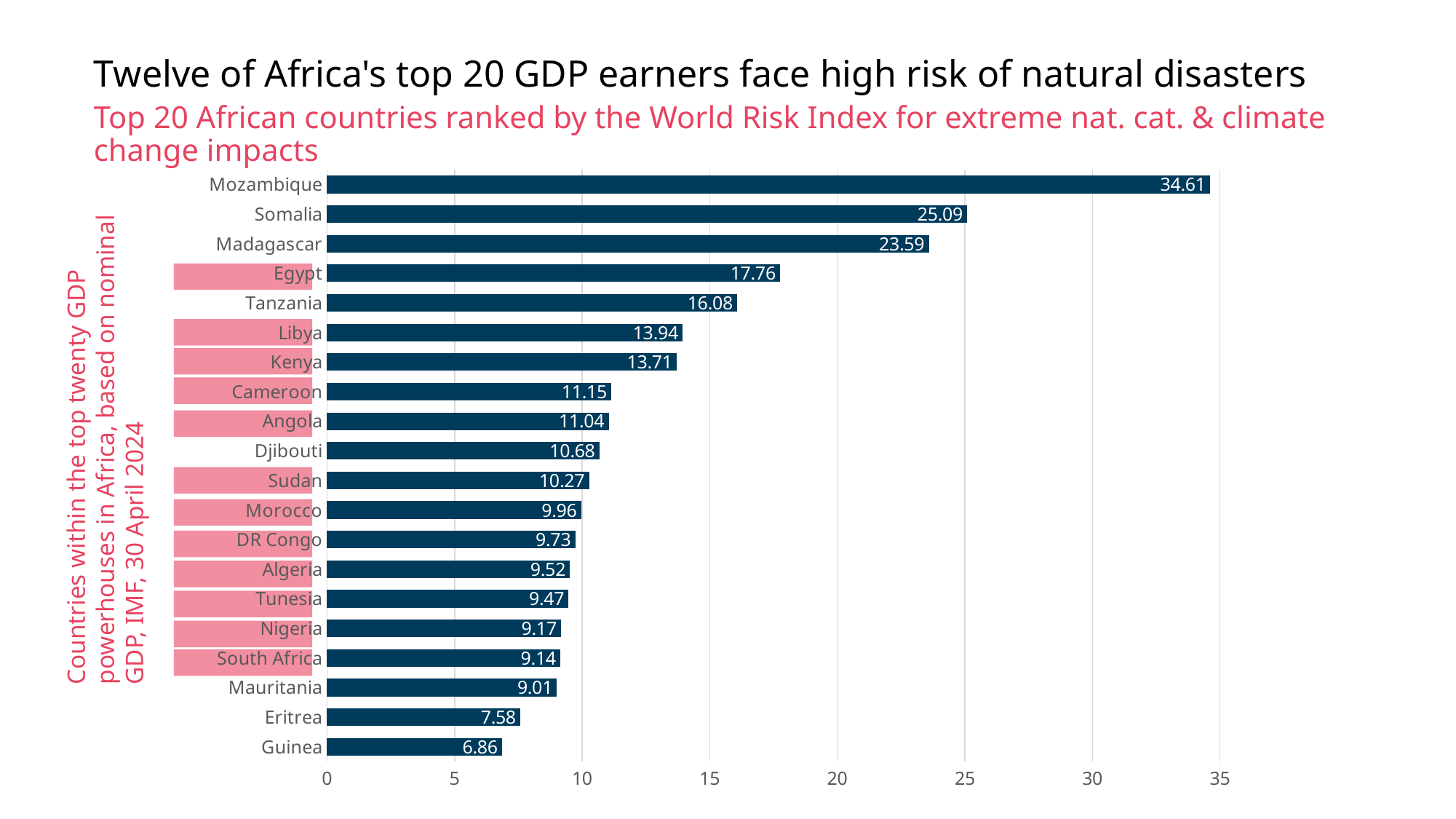
What is the value shown for Kenya? 13.71 Which country has the highest value on the chart? Mozambique What is the value shown for South Africa? 9.14 Which has a higher value, Libya or Cameroon? Libya What is the difference between the values for Egypt and Tanzania? 1.68 What does the pink highlighting behind some country names indicate? Countries within the top twenty GDP powerhouses in Africa What is the World Risk Index value for Mozambique? 34.61 What is the difference between the values for Somalia and Madagascar? 1.50 Is the value for Djibouti greater or less than 10? greater What kind of chart is shown on the slide? Bar chart How many countries are shown on the chart? 20 Which country has the lowest value on the chart? Guinea